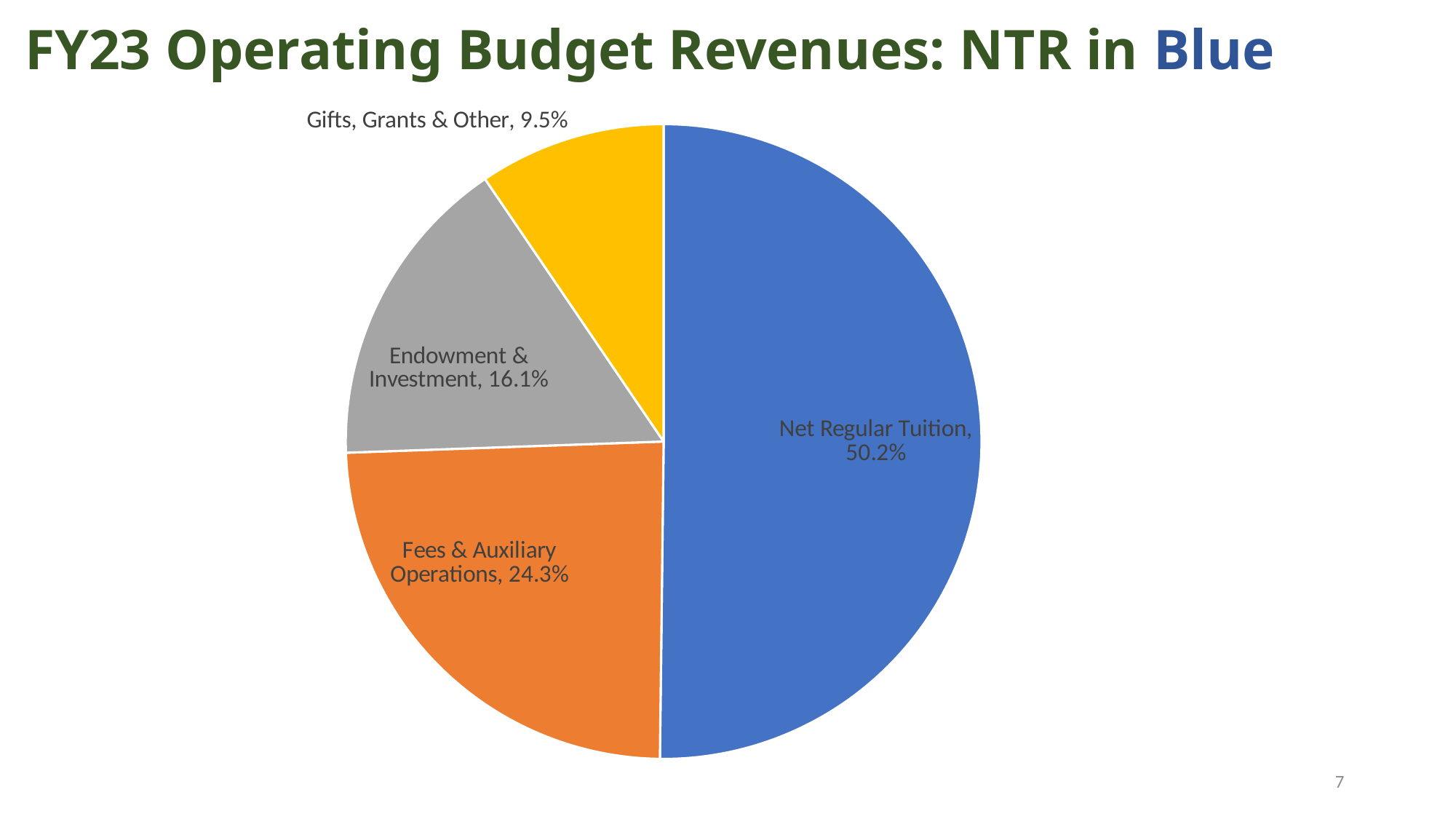
What percentage is shown for Endowment & Investment? 16.1% What is the difference in percentage points between Net Regular Tuition and Fees & Auxiliary Operations? 25.9 What share of FY23 operating budget revenues comes from Net Regular Tuition? 50.2% What is the difference in percentage points between Fees & Auxiliary Operations and Endowment & Investment? 8.2 Which revenue category has the smallest slice of the pie? Gifts, Grants & Other What colour is the Net Regular Tuition slice? Blue What percentage is shown for Gifts, Grants & Other? 9.5% Which is larger, Endowment & Investment or Gifts, Grants & Other? Endowment & Investment How many slices does the pie chart have? 4 What percentage is shown for Fees & Auxiliary Operations? 24.3% What kind of chart is shown on the slide? Pie chart Which revenue category has the largest slice of the pie? Net Regular Tuition